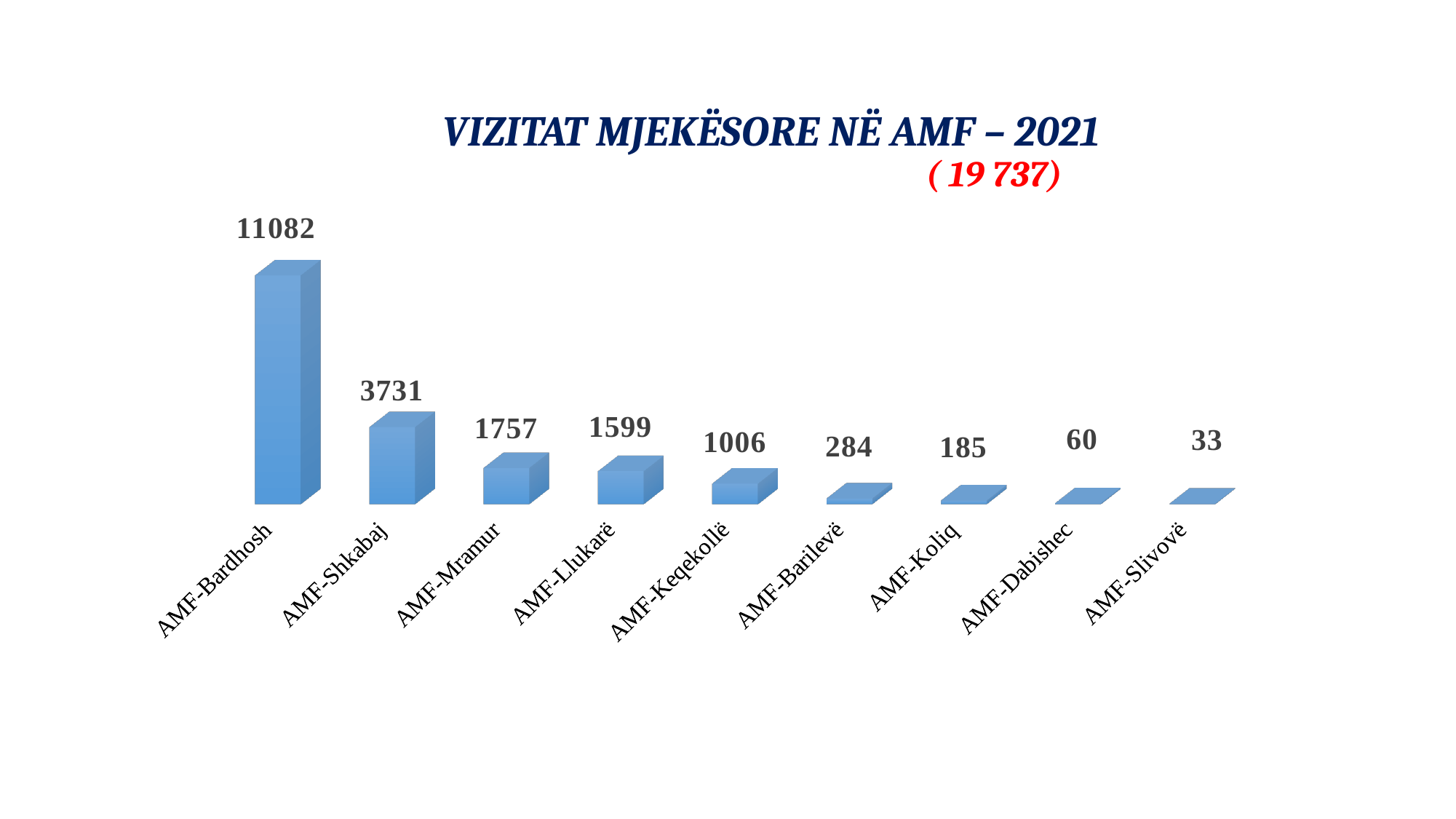
What is the value for AMF-Koliq? 185 What kind of chart is shown on the slide? bar chart How many categories are shown in the chart? 9 What is the value for AMF-Bardhosh? 11082 Which category has the highest value? AMF-Bardhosh What is the title of the chart? VIZITAT MJEKËSORE NË AMF – 2021 Which is larger, the value for AMF-Barilevë or the value for AMF-Dabishec? AMF-Barilevë Which category has the lowest value? AMF-Slivovë What is the difference between the values for AMF-Bardhosh and AMF-Shkabaj? 7351 What is the value for AMF-Keqekollë? 1006 What is the difference between the values for AMF-Mramur and AMF-Llukarë? 158 What is the value for AMF-Shkabaj? 3731